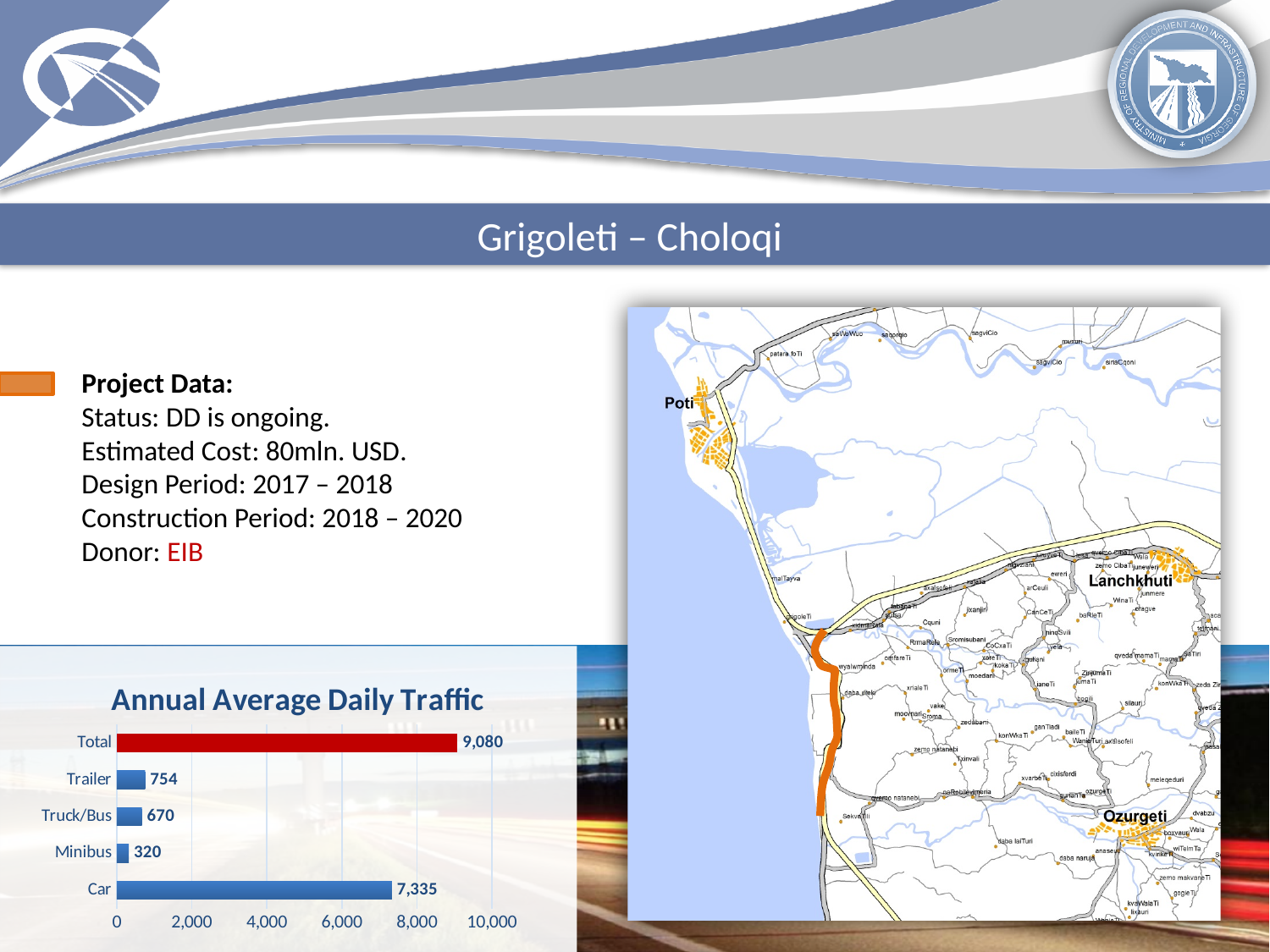
What is the difference between the Trailer and Truck/Bus values in the Annual Average Daily Traffic chart? 84 What type of chart is the Annual Average Daily Traffic chart? Bar chart What is the value for Car in the Annual Average Daily Traffic chart? 7,335 Which is larger in the Annual Average Daily Traffic chart, Trailer or Minibus? Trailer What is the value for Trailer in the Annual Average Daily Traffic chart? 754 What is the value for Truck/Bus in the Annual Average Daily Traffic chart? 670 How many categories are shown in the Annual Average Daily Traffic chart? 5 Excluding Total, which vehicle category has the highest value in the Annual Average Daily Traffic chart? Car What is the value for Minibus in the Annual Average Daily Traffic chart? 320 What is the difference between the Total and Car values in the Annual Average Daily Traffic chart? 1,745 Is the value for Car in the Annual Average Daily Traffic chart greater or less than 6,000? greater Which category has the lowest value in the Annual Average Daily Traffic chart? Minibus